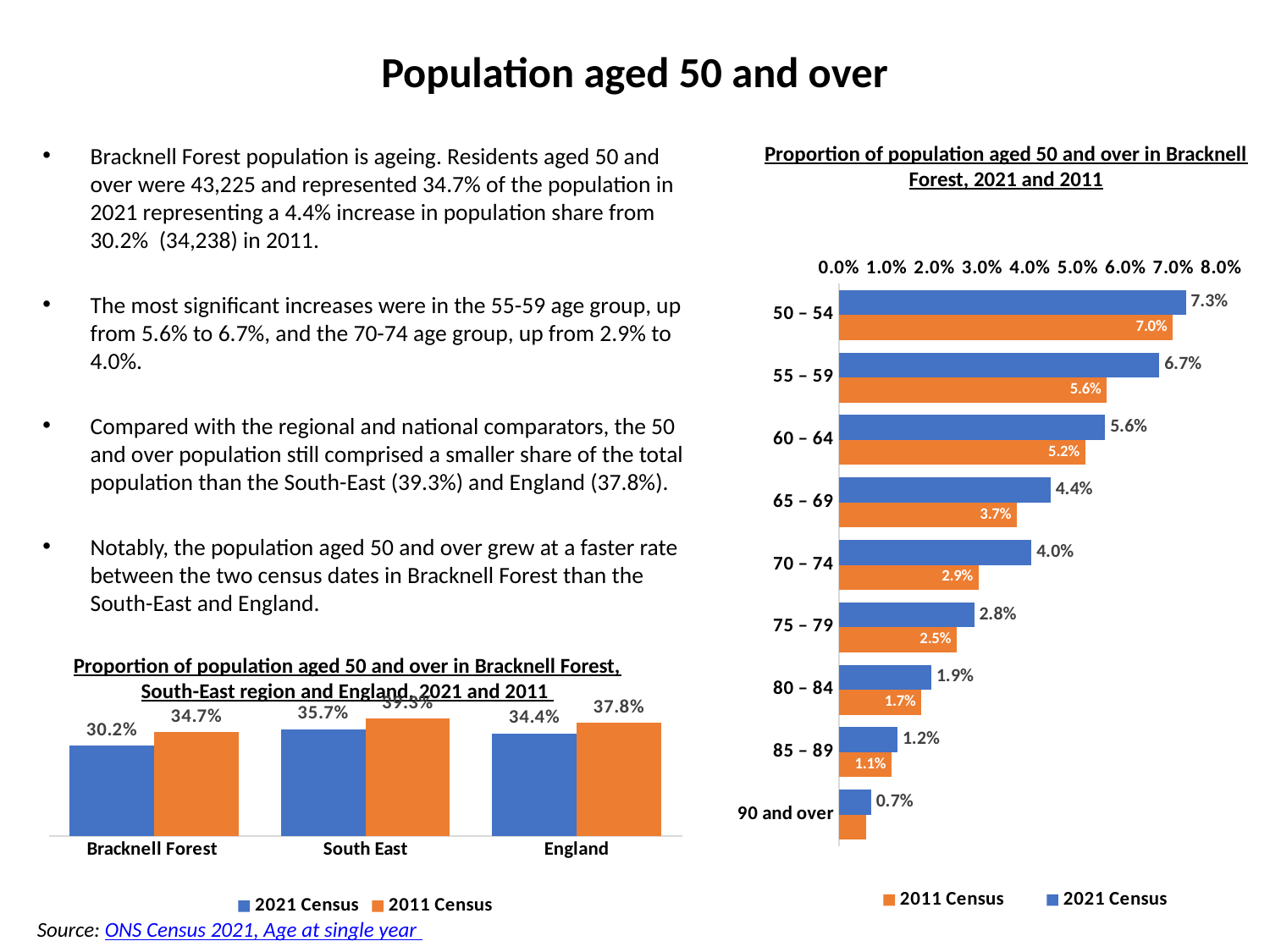
What kind of chart is the bottom-left chart comparing Bracknell Forest, South East and England? bar chart In the chart 'Proportion of population aged 50 and over in Bracknell Forest, 2021 and 2011', what is the 2011 Census value for the 70 – 74 age group? 2.9% In the chart 'Proportion of population aged 50 and over in Bracknell Forest, 2021 and 2011', which age group has the highest 2021 Census value? 50 – 54 In the chart 'Proportion of population aged 50 and over in Bracknell Forest, 2021 and 2011', do the 2021 Census values rise or fall as the age groups go from 50 – 54 to 90 and over? fall In the bottom-left chart comparing Bracknell Forest, South East and England, what value is shown on the orange bar for England? 37.8% In the chart 'Proportion of population aged 50 and over in Bracknell Forest, 2021 and 2011', is the 2011 Census value for the 90 and over age group greater or less than 1.0%? less How many series does the legend list in the chart 'Proportion of population aged 50 and over in Bracknell Forest, 2021 and 2011'? 2 In the chart 'Proportion of population aged 50 and over in Bracknell Forest, 2021 and 2011', what is the 2021 Census value for the 55 – 59 age group? 6.7% In the chart 'Proportion of population aged 50 and over in Bracknell Forest, 2021 and 2011', which age group has the lowest 2021 Census value? 90 and over How many age groups are shown in the chart 'Proportion of population aged 50 and over in Bracknell Forest, 2021 and 2011'? 9 In the chart 'Proportion of population aged 50 and over in Bracknell Forest, 2021 and 2011', what is the difference between the 2021 Census and 2011 Census values for the 65 – 69 age group? 0.7% In the chart 'Proportion of population aged 50 and over in Bracknell Forest, 2021 and 2011', which is larger for the 60 – 64 age group, the 2021 Census value or the 2011 Census value? 2021 Census